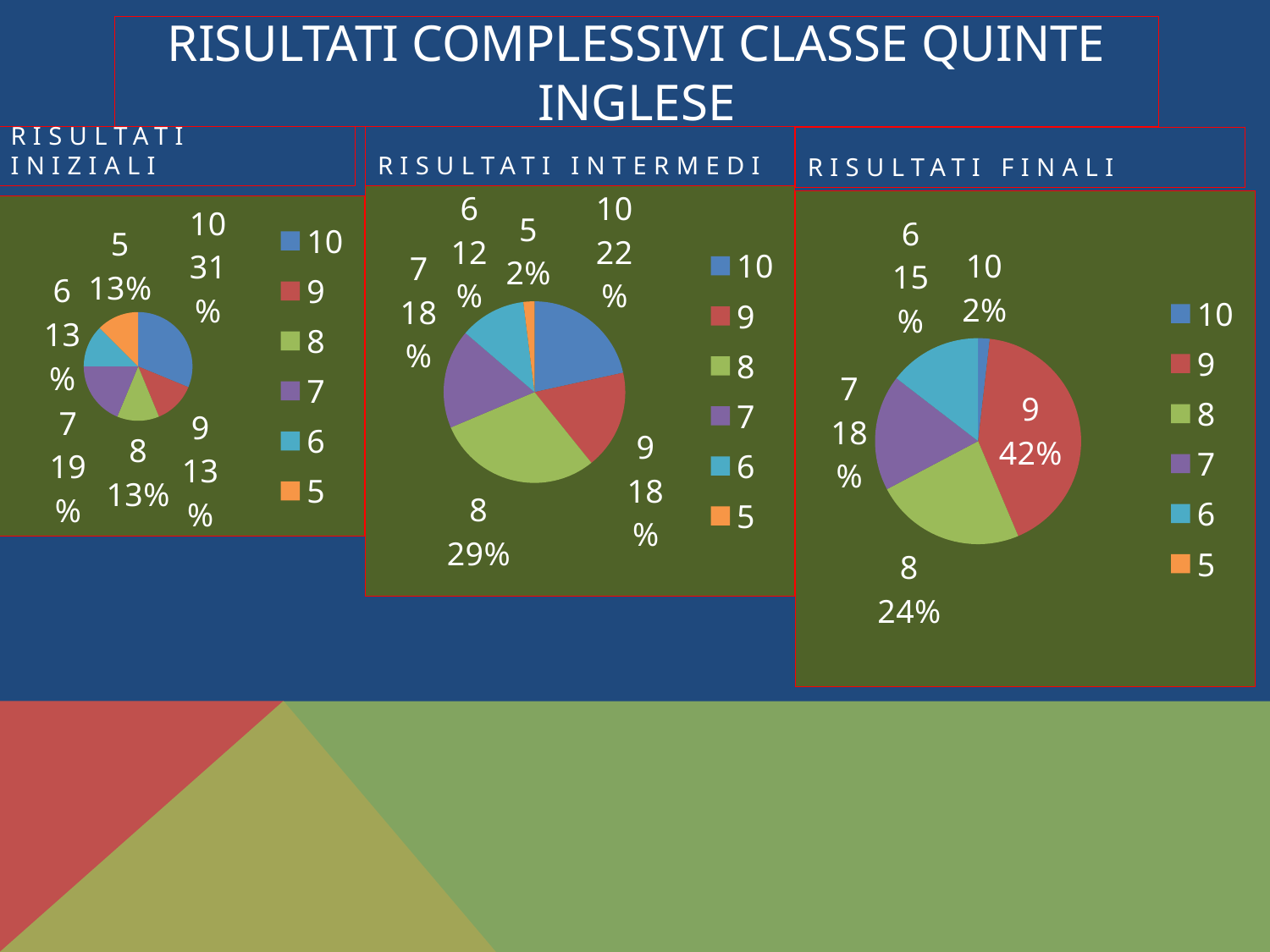
What kind of chart is the RISULTATI INTERMEDI chart? Pie chart In the RISULTATI INTERMEDI chart, what is the difference in percentage points between category 10 and category 6? 10 In the RISULTATI INIZIALI chart, what share of the pie does category 10 have? 31% In the RISULTATI INIZIALI chart, what share does category 7 have? 19% In the RISULTATI FINALI chart, what share of the pie does category 9 have? 42% In the RISULTATI FINALI chart, which category has the largest slice? 9 In the RISULTATI FINALI chart, which is larger, the share for category 8 or the share for category 7? 8 In the RISULTATI INTERMEDI chart, which category has the smallest slice? 5 In the RISULTATI INIZIALI chart, which category has the largest slice? 10 How many entries does the legend of the RISULTATI FINALI chart list? 6 In the RISULTATI FINALI chart, what is the difference in percentage points between category 9 and category 8? 18